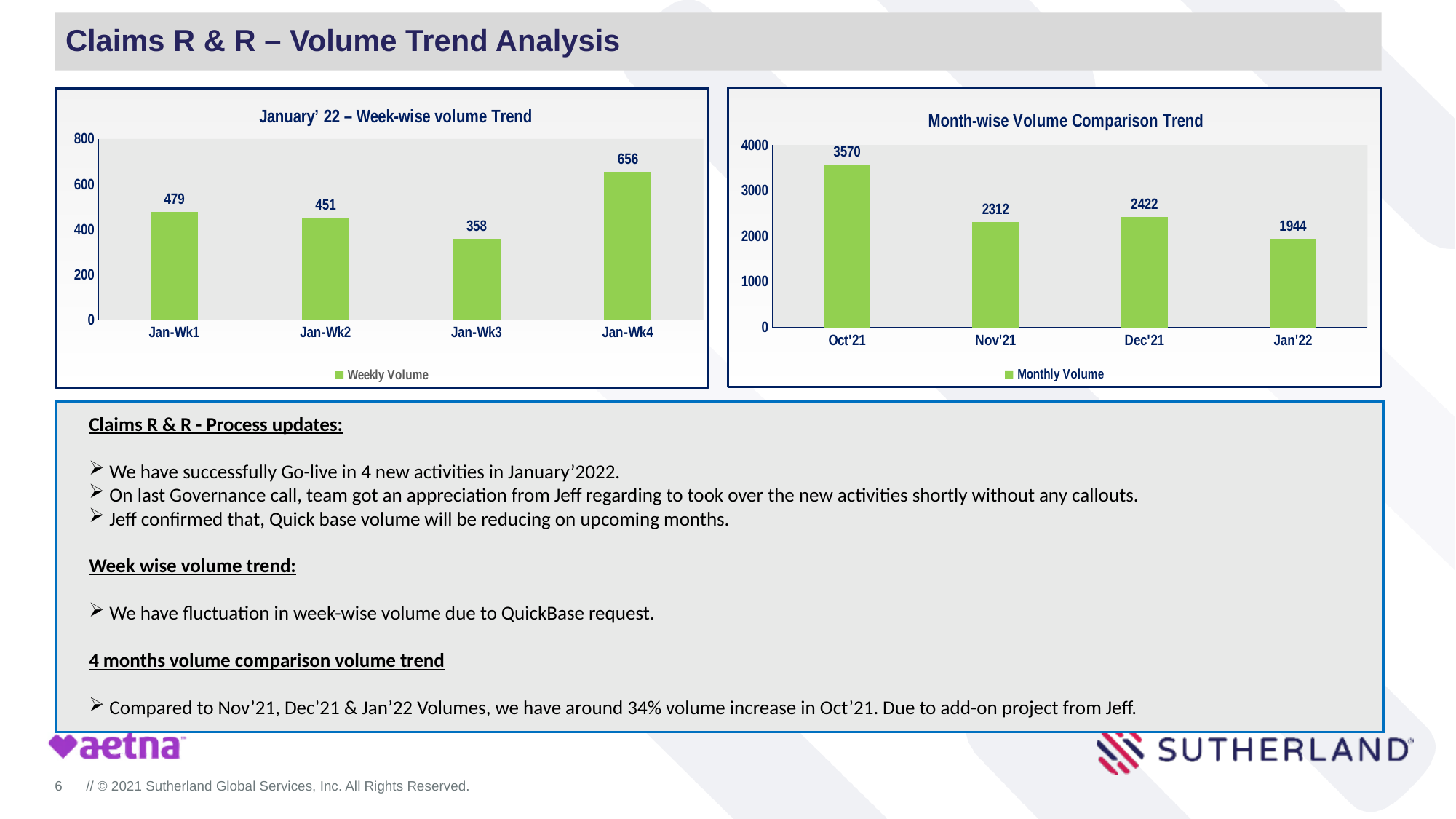
In the 'Month-wise Volume Comparison Trend' chart, which month has the highest volume? Oct'21 In the 'Month-wise Volume Comparison Trend' chart, which is larger, the volume for Nov'21 or Dec'21? Dec'21 In the 'January' 22 – Week-wise volume Trend' chart, how many weeks are plotted? 4 In the 'Month-wise Volume Comparison Trend' chart, what is the monthly volume for Dec'21? 2422 What kind of chart is the 'January' 22 – Week-wise volume Trend' chart? Bar chart In the 'January' 22 – Week-wise volume Trend' chart, which week has the lowest volume? Jan-Wk3 In the 'Month-wise Volume Comparison Trend' chart, what is the difference between the volumes for Oct'21 and Nov'21? 1258 In the 'January' 22 – Week-wise volume Trend' chart, what is the difference between the volumes for Jan-Wk4 and Jan-Wk1? 177 What is the legend entry in the 'Month-wise Volume Comparison Trend' chart? Monthly Volume In the 'January' 22 – Week-wise volume Trend' chart, which week has the highest volume? Jan-Wk4 In the 'January' 22 – Week-wise volume Trend' chart, what is the weekly volume for Jan-Wk3? 358 In the 'Month-wise Volume Comparison Trend' chart, which month has the lowest volume? Jan'22